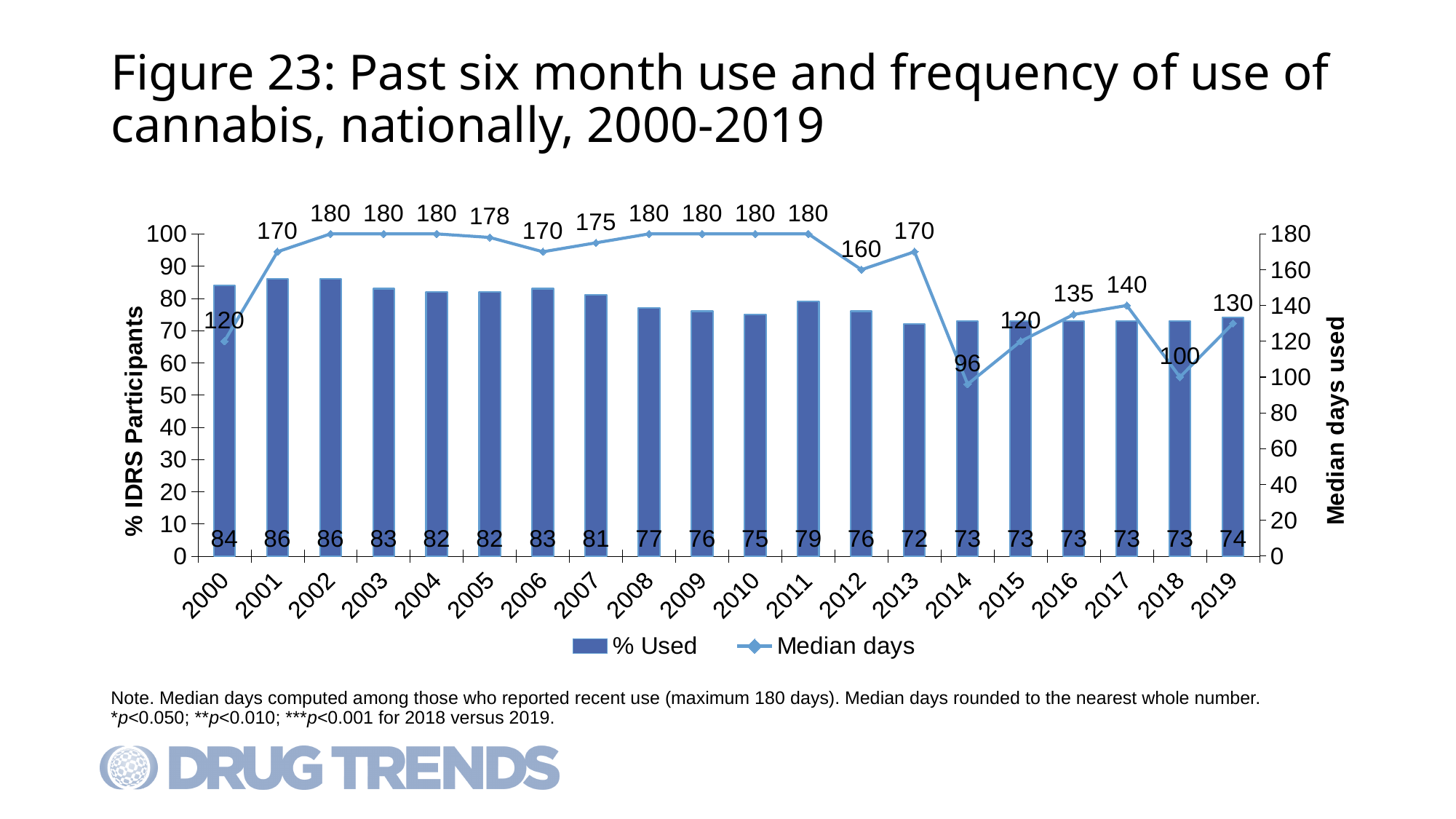
How many years are shown on the x axis? 20 What is the difference between the % Used values for 2001 and 2013? 14 Which year has the lowest Median days value? 2014 What is the % Used value for 2000? 84 Which is larger, the Median days value for 2012 or for 2013? 2013 What is the % Used value for 2011? 79 How many series does the legend list? 2 What is the Median days value for 2019? 130 Which year has the lowest % Used value? 2013 What is the Median days value for 2014? 96 What is the label of the right-hand vertical axis? Median days used What is the difference between the Median days values for 2017 and 2018? 40